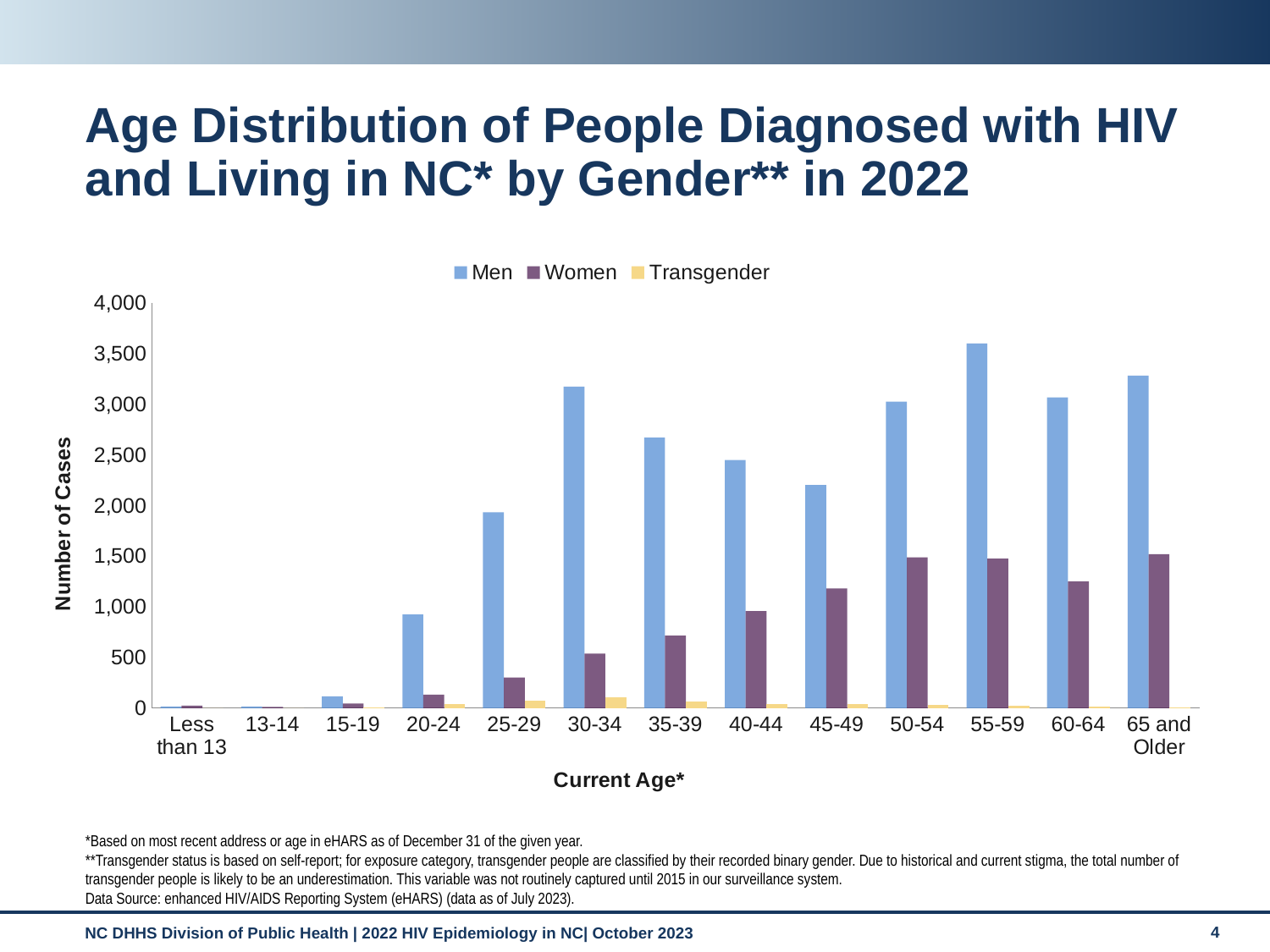
Which age group has the highest number of cases for Men? 55-59 Is the value for Women in the 45-49 age group greater or less than 1,000? greater Is the value for Men in the 30-34 age group greater or less than 3,000? greater How many series does the legend list? 3 How many age groups are shown on the x axis? 13 What is the label of the y axis? Number of Cases What kind of chart is shown on the slide? Bar chart Is the value for Men in the 55-59 age group greater or less than 3,500? greater Which is larger: the number of cases for Men aged 30-34 or Men aged 35-39? Men aged 30-34 Do the values for Women rise or fall from the 20-24 age group to the 45-49 age group? Rise Which is larger: the number of cases for Women aged 40-44 or Women aged 45-49? Women aged 45-49